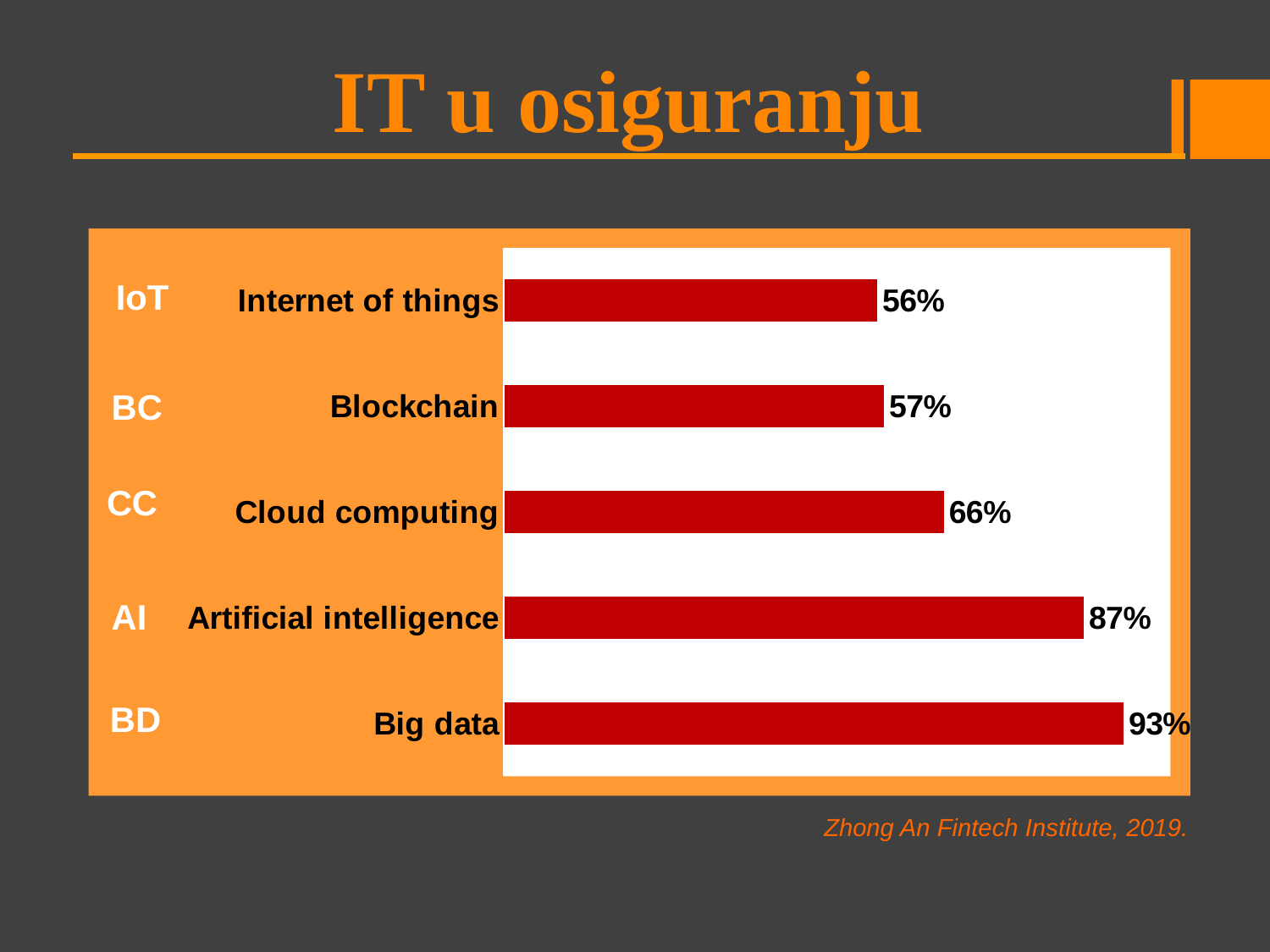
What is the value for Artificial intelligence? 87% Which category has the lowest value? Internet of things What is the difference between the values for Big data and Artificial intelligence? 6% What is the value for Cloud computing? 66% What is the difference between the values for Cloud computing and Blockchain? 9% What is the value for Internet of things? 56% Which is larger, the value for Cloud computing or the value for Blockchain? Cloud computing What kind of chart is shown on the slide? Bar chart How many categories are shown in the chart? 5 Which category has the highest value? Big data What is the source cited below the chart? Zhong An Fintech Institute, 2019. What is the value for Big data? 93%